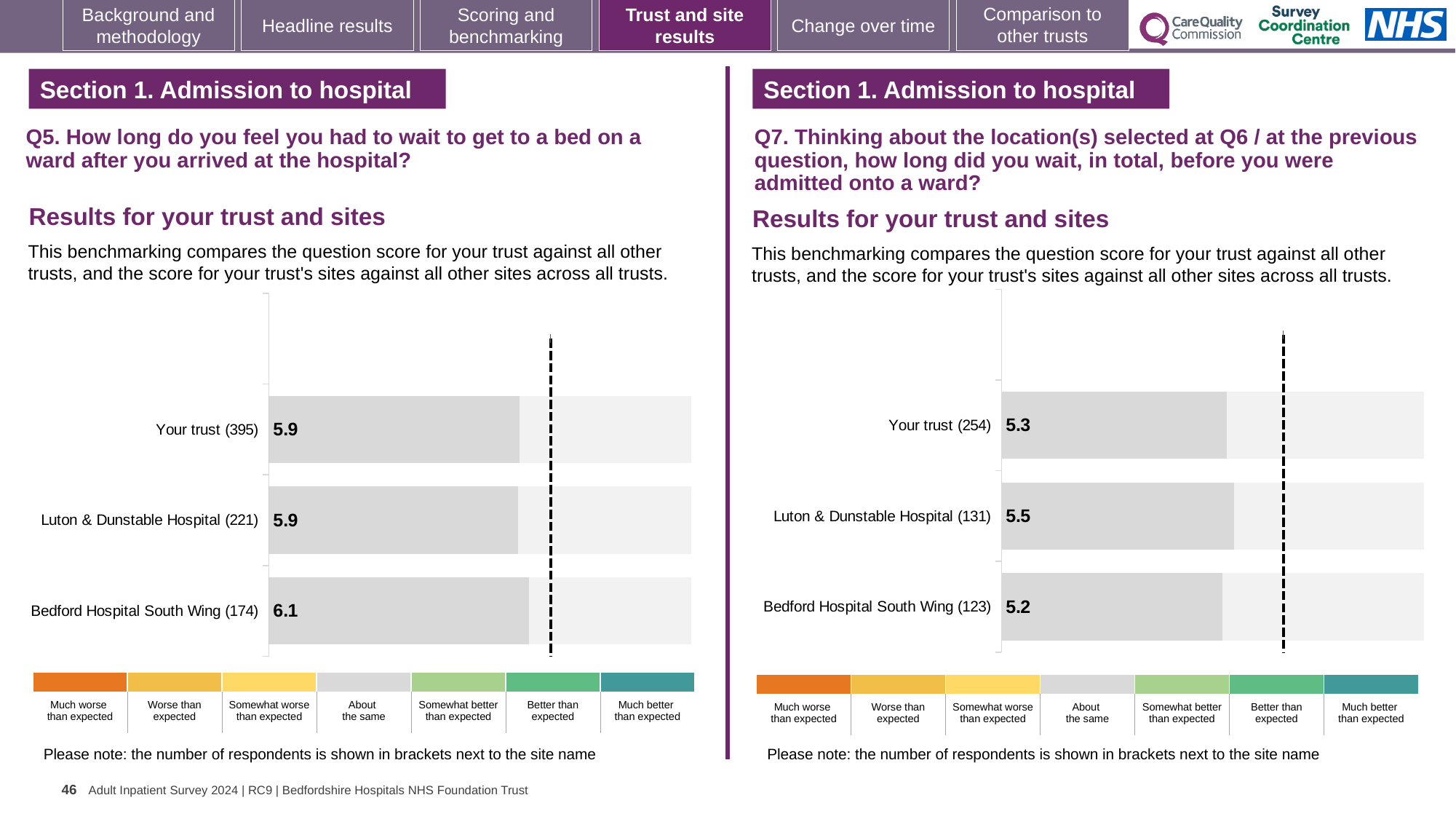
On the Q5 chart (left), what is the difference between the scores for Bedford Hospital South Wing and Luton & Dunstable Hospital? 0.2 On the Q5 chart (left), which site or trust has the highest score? Bedford Hospital South Wing What kind of chart is used on the Q5 chart (left)? Bar chart On the Q7 chart (right), what is the difference between the scores for Luton & Dunstable Hospital and Your trust? 0.2 On the Q7 chart (right), what is the score for Luton & Dunstable Hospital? 5.5 On the Q5 chart (left), what is the score for Your trust? 5.9 On the Q7 chart (right), which site or trust has the lowest score? Bedford Hospital South Wing On the Q5 chart (left), what is the score for Bedford Hospital South Wing? 6.1 On the Q5 chart (left), how many bars are plotted? 3 On the Q7 chart (right), which has the higher score: Your trust or Luton & Dunstable Hospital? Luton & Dunstable Hospital On the Q7 chart (right), how many respondents are shown in brackets for Your trust? 254 On the Q7 chart (right), what is the score for Bedford Hospital South Wing? 5.2